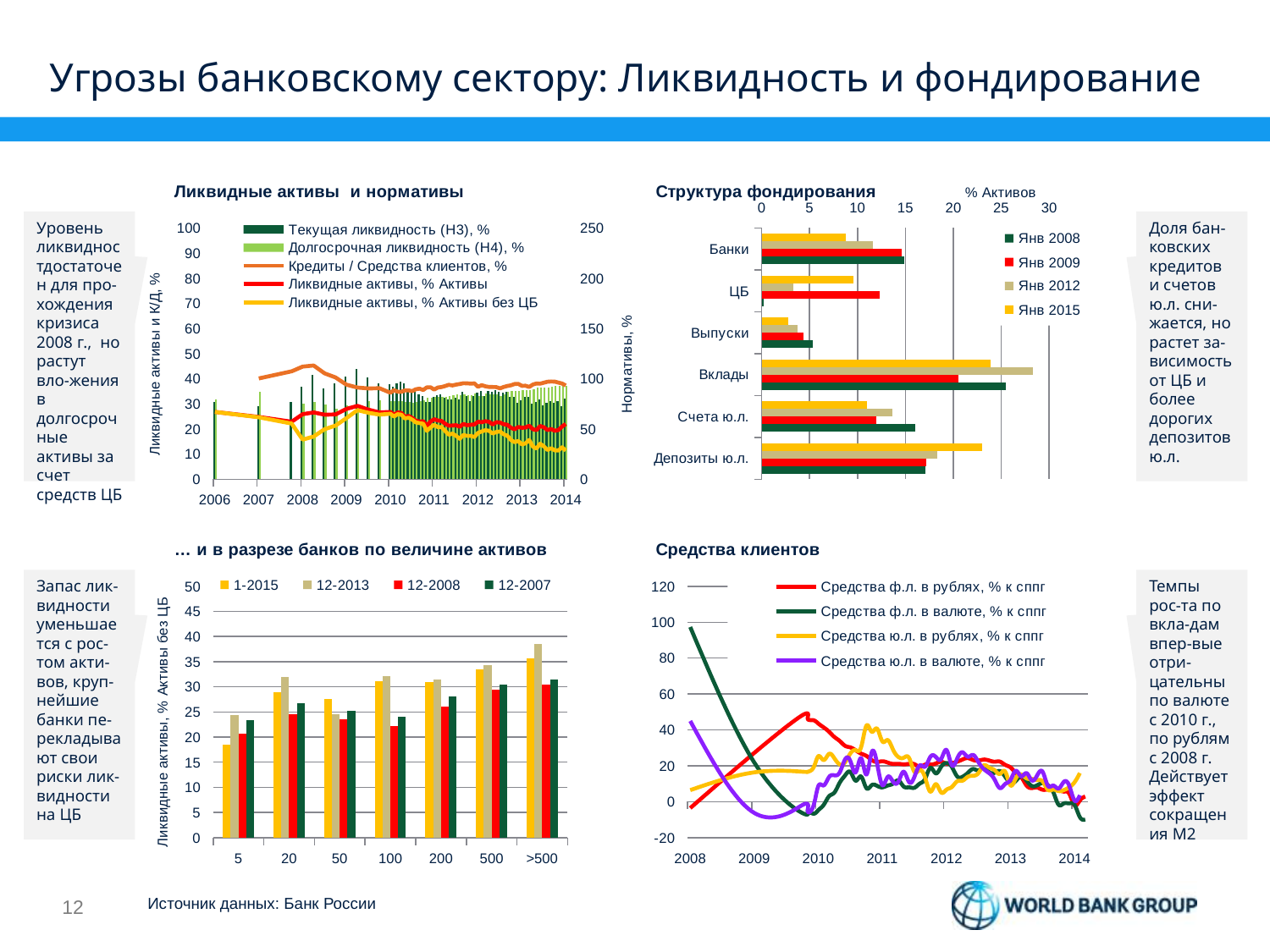
In the '… и в разрезе банков по величине активов' chart, is the value for >500 in 12-2013 greater or less than 35? greater In the 'Структура фондирования' chart, is the value for Банки in Янв 2015 greater or less than 10? less How many categories are shown on the 'Структура фондирования' chart? 6 In the 'Средства клиентов' chart, does the series 'Средства ф.л. в валюте, % к сппг' rise or fall between 2008 and 2010? fall In the 'Структура фондирования' chart, is the value for Вклады in Янв 2012 greater or less than 25? greater In the '… и в разрезе банков по величине активов' chart, which category has the lowest 1-2015 value? 5 What kind of chart is 'Средства клиентов'? line chart How many categories are on the x axis of the '… и в разрезе банков по величине активов' chart? 7 How many series does the legend of the 'Структура фондирования' chart list? 4 What kind of chart is 'Структура фондирования'? bar chart How many series does the legend of the 'Ликвидные активы и нормативы' chart list? 5 In the '… и в разрезе банков по величине активов' chart, which category has the highest 12-2013 value? >500